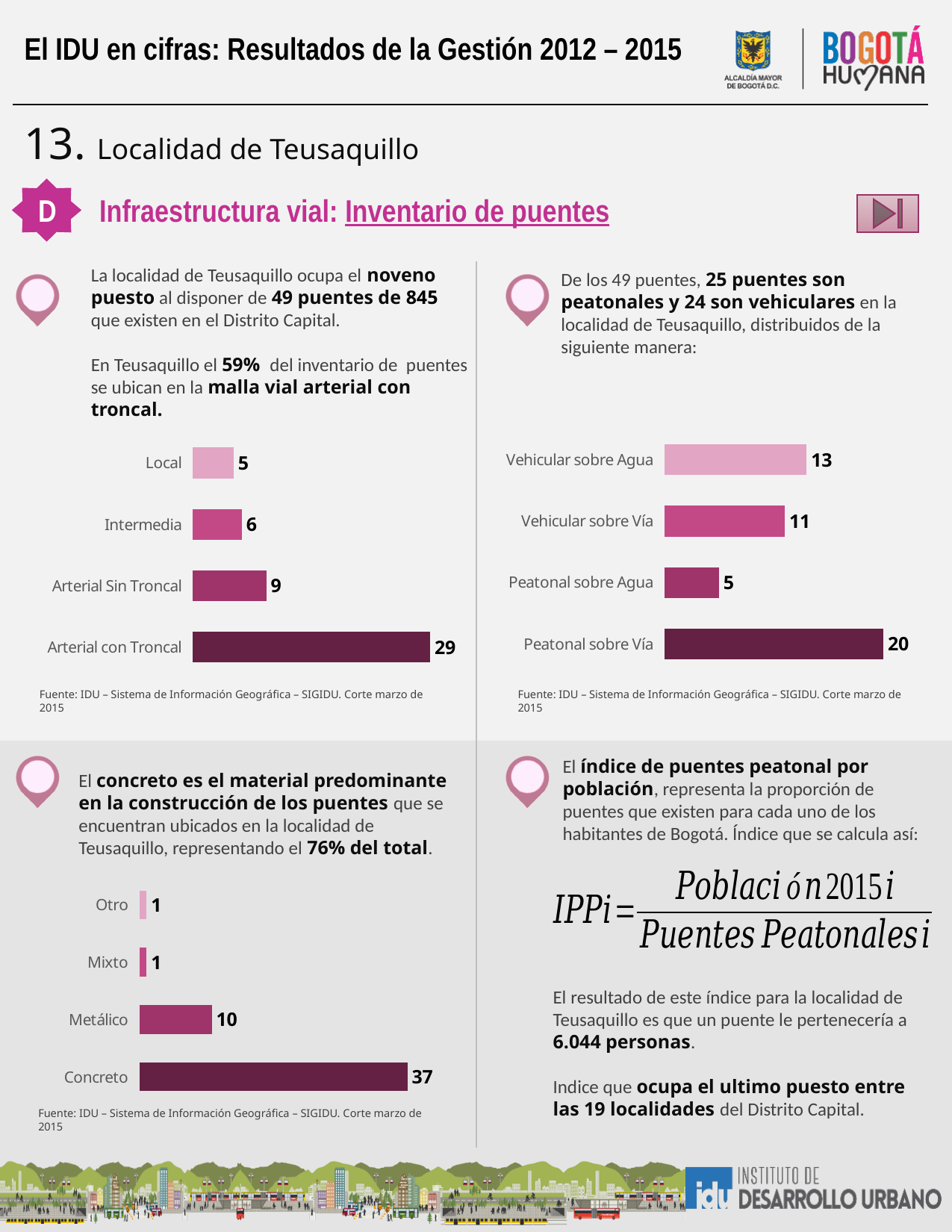
What type of chart is the bottom-left chart? Bar chart In the top-left bar chart, what is the difference between Arterial con Troncal and Arterial Sin Troncal? 20 In the top-right bar chart, which is larger: Vehicular sobre Agua or Vehicular sobre Vía? Vehicular sobre Agua In the top-left bar chart, which category has the lowest value? Local In the bottom-left bar chart, what is the difference between Concreto and Metálico? 27 In the bottom-left bar chart, what is the value for Metálico? 10 In the top-right bar chart, which category has the highest value? Peatonal sobre Vía In the top-right bar chart, what is the value for Vehicular sobre Agua? 13 In the top-left bar chart, what is the value for Arterial con Troncal? 29 How many categories does the top-left bar chart show? 4 In the bottom-left bar chart, which category has the highest value? Concreto In the top-right bar chart, what is the difference between Peatonal sobre Vía and Peatonal sobre Agua? 15